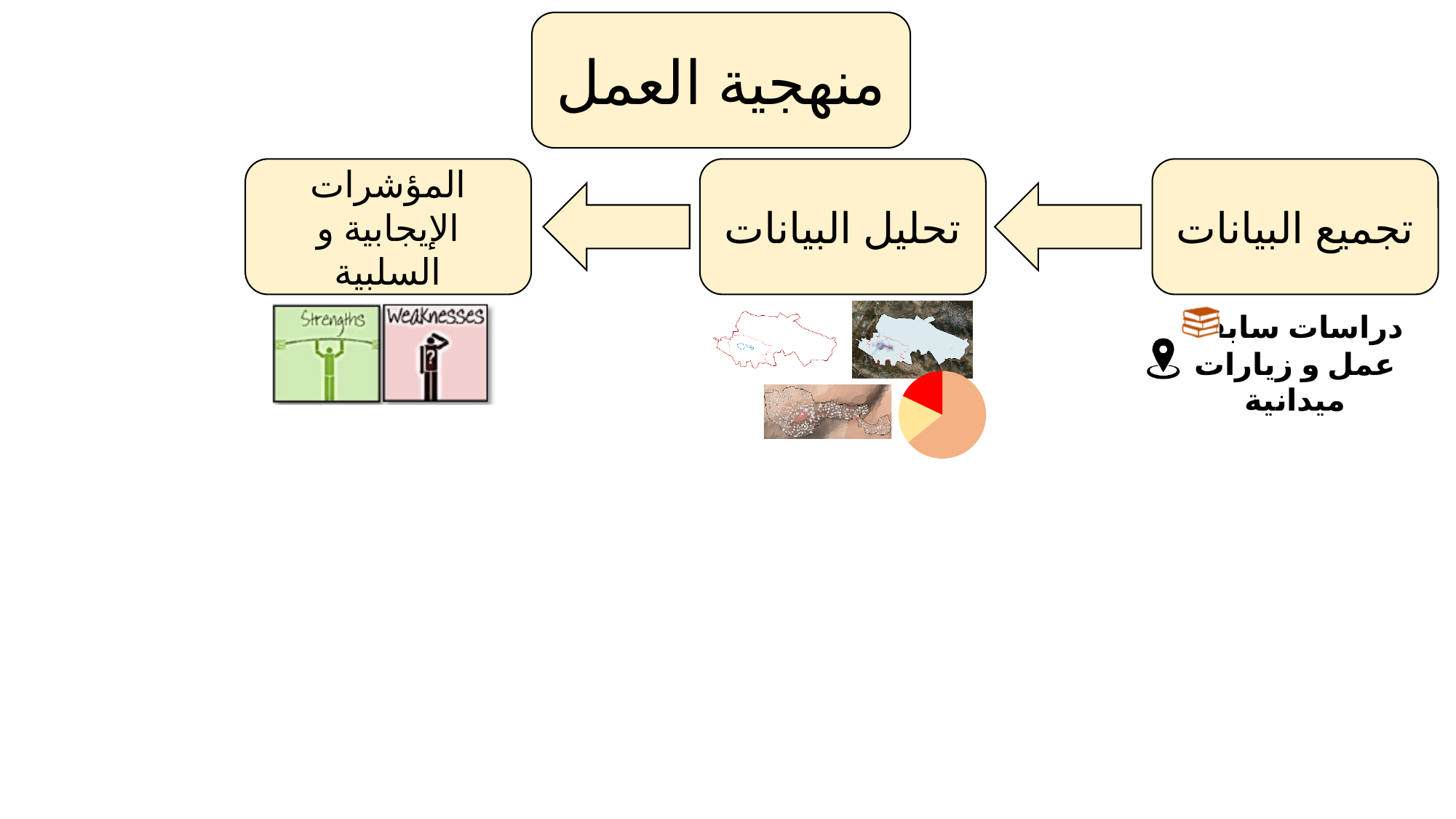
Which colour slice takes up the largest share of the pie chart? orange What kind of chart is shown under the "تحليل البيانات" box? pie chart Does the orange slice of the pie chart cover more or less than half of the pie? more Does the pie chart on the slide show a legend? no What colours are the three slices of the pie chart? red, yellow and orange How many slices does the pie chart on the slide have? 3 Which is larger in the pie chart, the orange slice or the red slice? orange